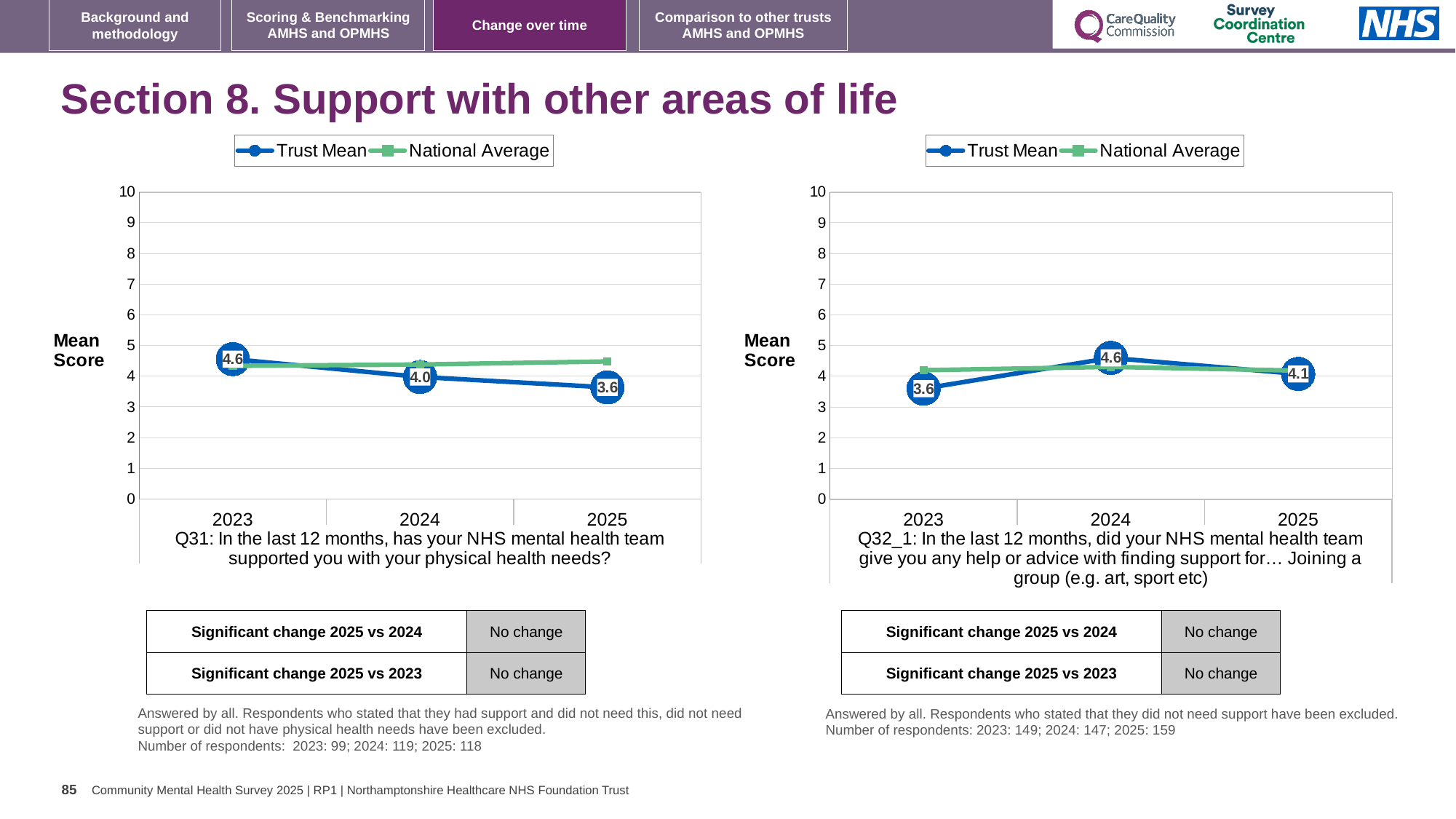
What type of chart is the Q32_1 chart on the right? line chart In the Q31 chart on the left, what is the Trust Mean score for 2025? 3.6 In the Q31 chart on the left, what is the Trust Mean score for 2023? 4.6 In the Q32_1 chart on the right, what is the Trust Mean score for 2023? 3.6 In the Q32_1 chart on the right, is the National Average value for 2023 greater or less than 5? less In the Q31 chart on the left, which year has the lowest Trust Mean score? 2025 In the Q31 chart on the left, does the Trust Mean rise or fall from 2023 to 2025? fall How many series does the legend of the Q31 chart on the left list? 2 In the Q32_1 chart on the right, is the Trust Mean score for 2024 larger or smaller than the score for 2025? larger In the Q32_1 chart on the right, which year has the highest Trust Mean score? 2024 In the Q32_1 chart on the right, what is the Trust Mean score for 2024? 4.6 In the Q31 chart on the left, what is the difference between the Trust Mean scores for 2023 and 2025? 1.0